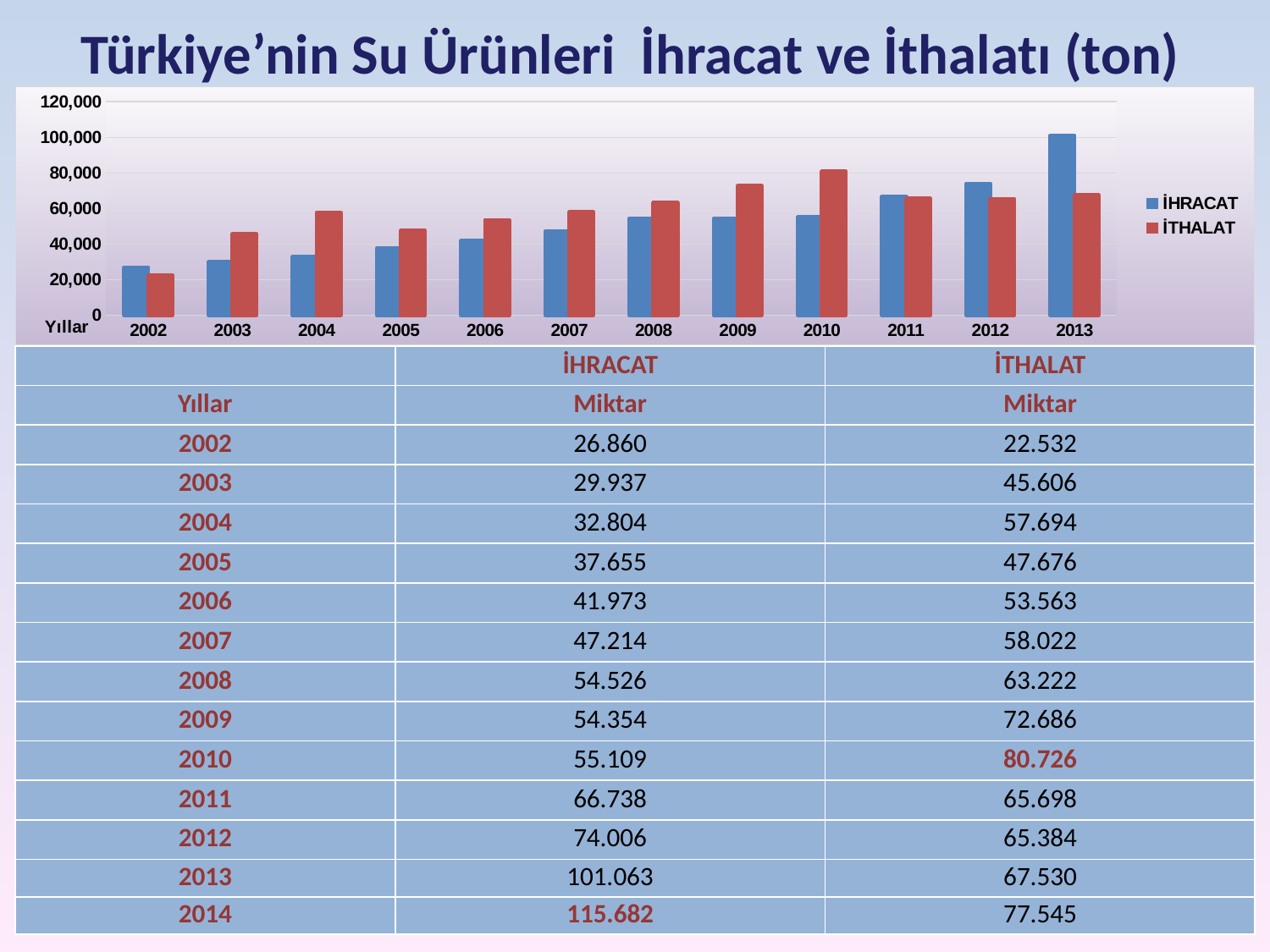
In 2010, which is larger, İHRACAT or İTHALAT? İTHALAT According to the table below the chart, what is the İHRACAT amount for 2013? 101.063 How many years are shown on the x axis of the chart? 12 In which year is the İTHALAT bar the highest? 2010 In which year is the İHRACAT bar the highest? 2013 What kind of chart is shown on the slide? bar chart How many series does the chart legend list? 2 Which colour represents İTHALAT in the chart? red Is the İHRACAT value for 2013 greater or less than 100,000? greater In 2013, which is larger, İHRACAT or İTHALAT? İHRACAT In which year is the İHRACAT bar the lowest? 2002 Is the İTHALAT value for 2002 greater or less than 40,000? less